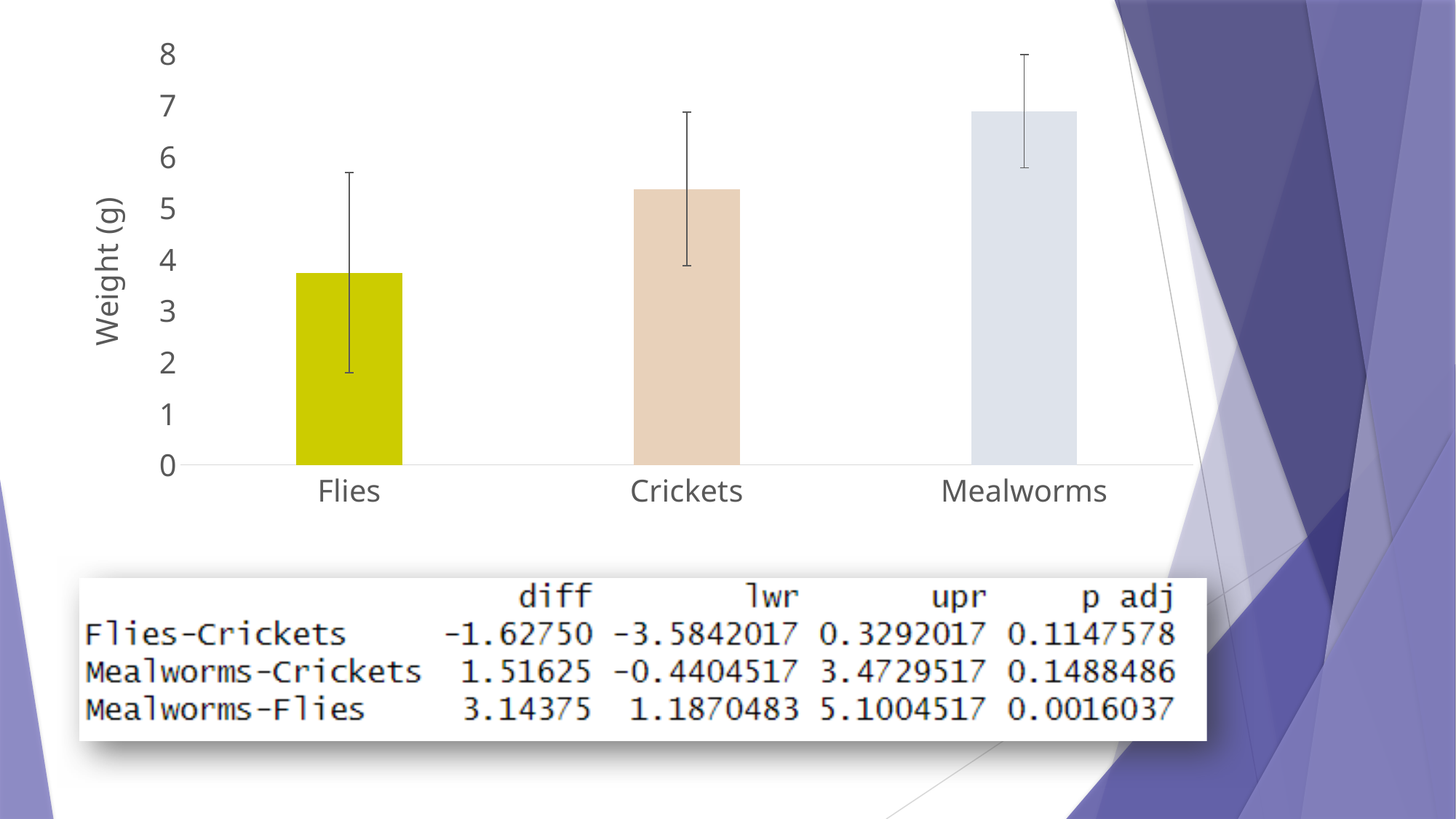
Is the value for Flies greater or less than 5? less What kind of chart is shown on the slide? bar chart Is the value for Crickets greater or less than 6? less Is the value for Flies greater or less than 3? greater Which has a larger weight in the bar chart, Crickets or Flies? Crickets What is the label on the y axis of the bar chart? Weight (g) How many categories are shown on the x axis of the bar chart? 3 Which category has the lowest weight in the bar chart? Flies Which has a larger weight in the bar chart, Mealworms or Crickets? Mealworms Which category has the highest weight in the bar chart? Mealworms Do the bar values rise or fall from Flies to Mealworms along the x axis? rise